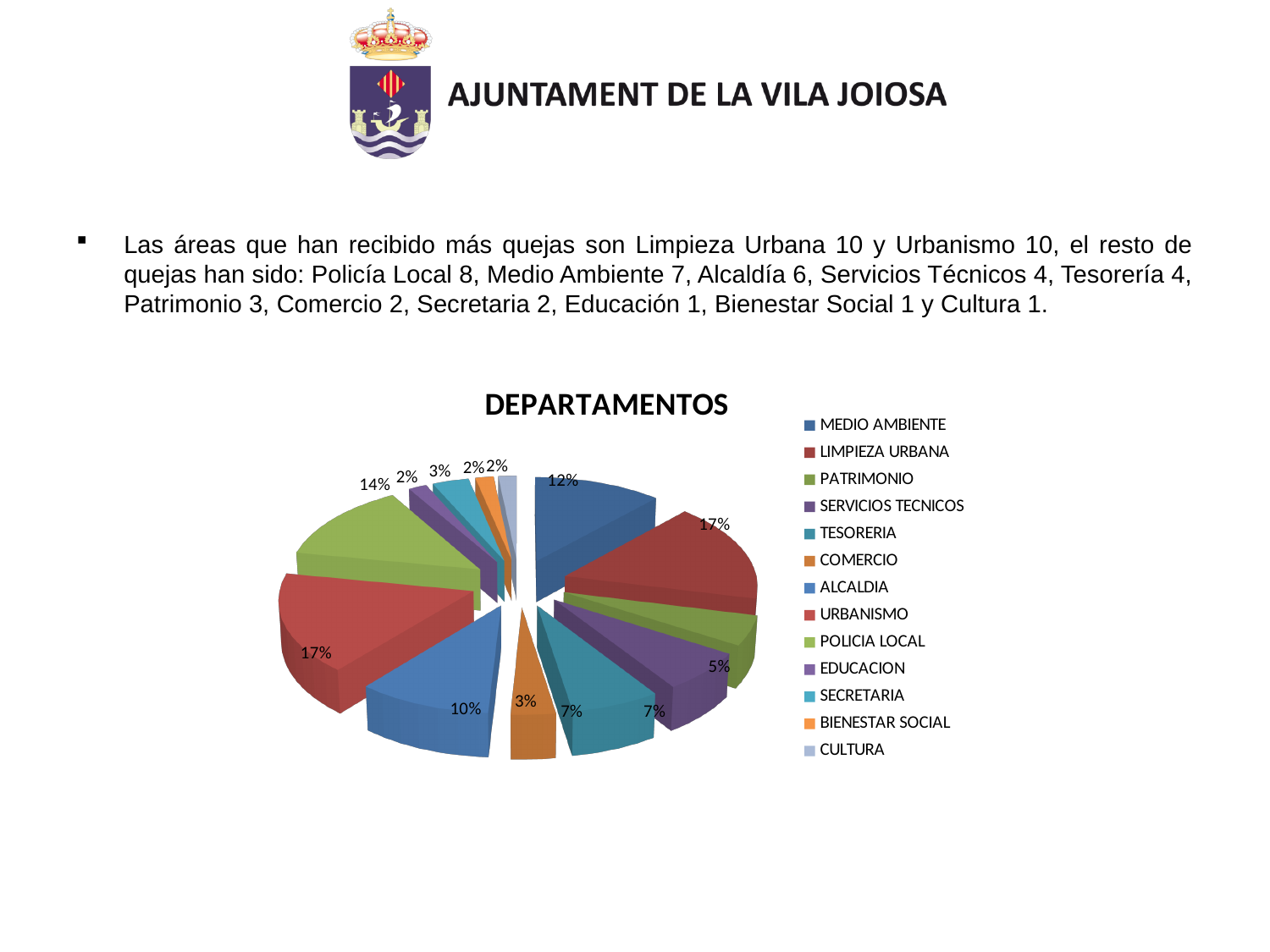
Which two departments share the largest slice of the pie at 17%? LIMPIEZA URBANA and URBANISMO What share of the pie does ALCALDIA represent? 10% Which is larger, the share for POLICIA LOCAL or the share for ALCALDIA? POLICIA LOCAL What share of the pie does POLICIA LOCAL represent? 14% How many categories does the legend of the DEPARTAMENTOS chart list? 13 What share of the pie does PATRIMONIO represent? 5% What is the title of the chart? DEPARTAMENTOS What type of chart is shown on the slide? pie chart Which legend entry is listed first in the DEPARTAMENTOS chart? MEDIO AMBIENTE What is the difference in percentage points between the share for LIMPIEZA URBANA and the share for MEDIO AMBIENTE? 5